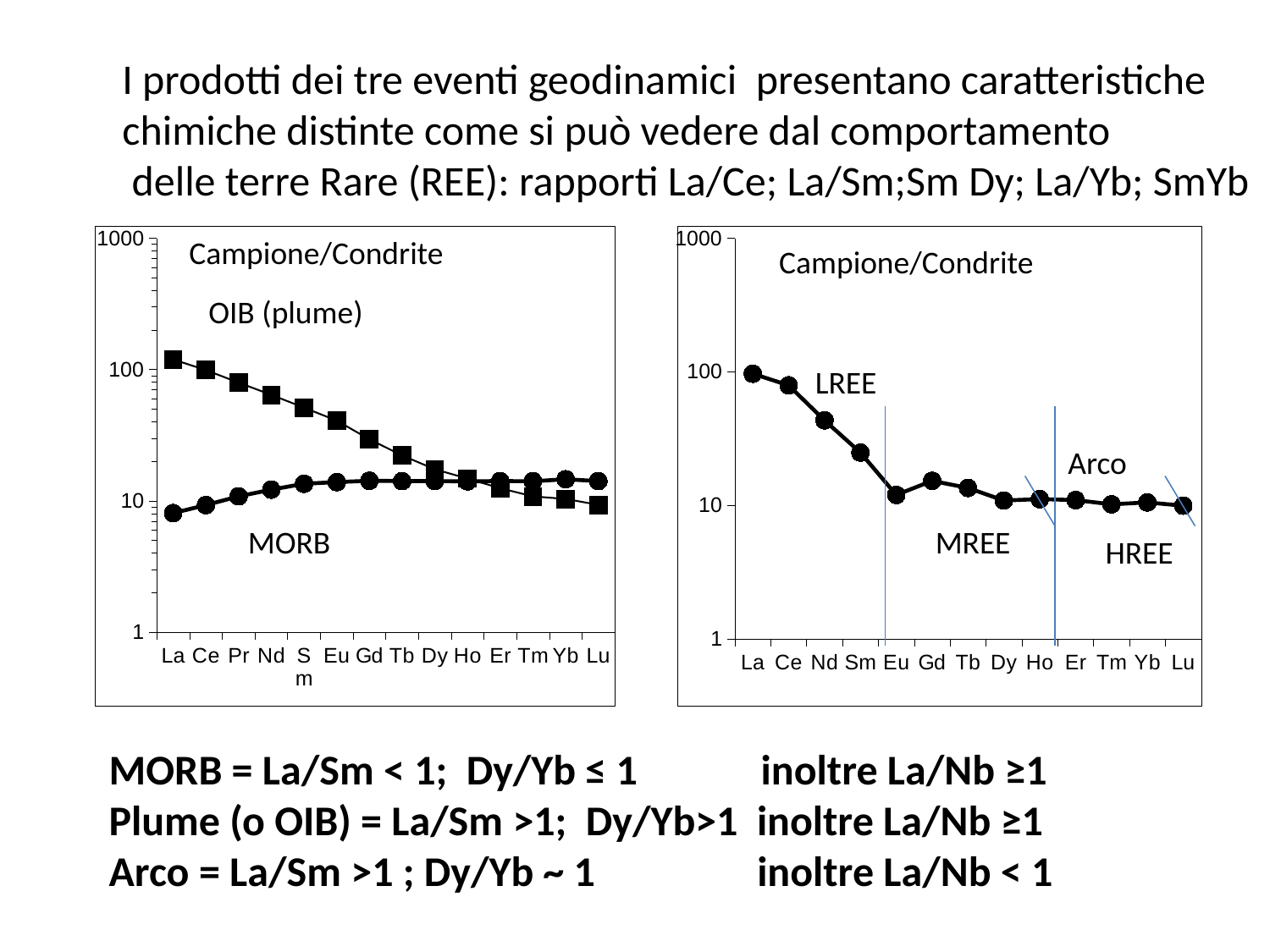
In the left chart, is the OIB (plume) value for La greater or less than 100? greater How many elements are listed along the x axis of the left chart (OIB/MORB)? 14 How many elements are listed along the x axis of the right chart (Arco)? 13 In the left chart, at which element is the OIB (plume) series highest? La In the right chart (Arco), at which element is the value highest? La What kind of chart is the left chart (OIB/MORB)? line chart In the left chart, which series has the larger value at Lu, OIB (plume) or MORB? MORB In the left chart, which series has the larger value at La, OIB (plume) or MORB? OIB (plume) In the left chart, is the MORB value for La greater or less than 10? less In the right chart (Arco), is the value for Nd greater or less than 100? less In the left chart, do the OIB (plume) values rise or fall from La to Lu? fall